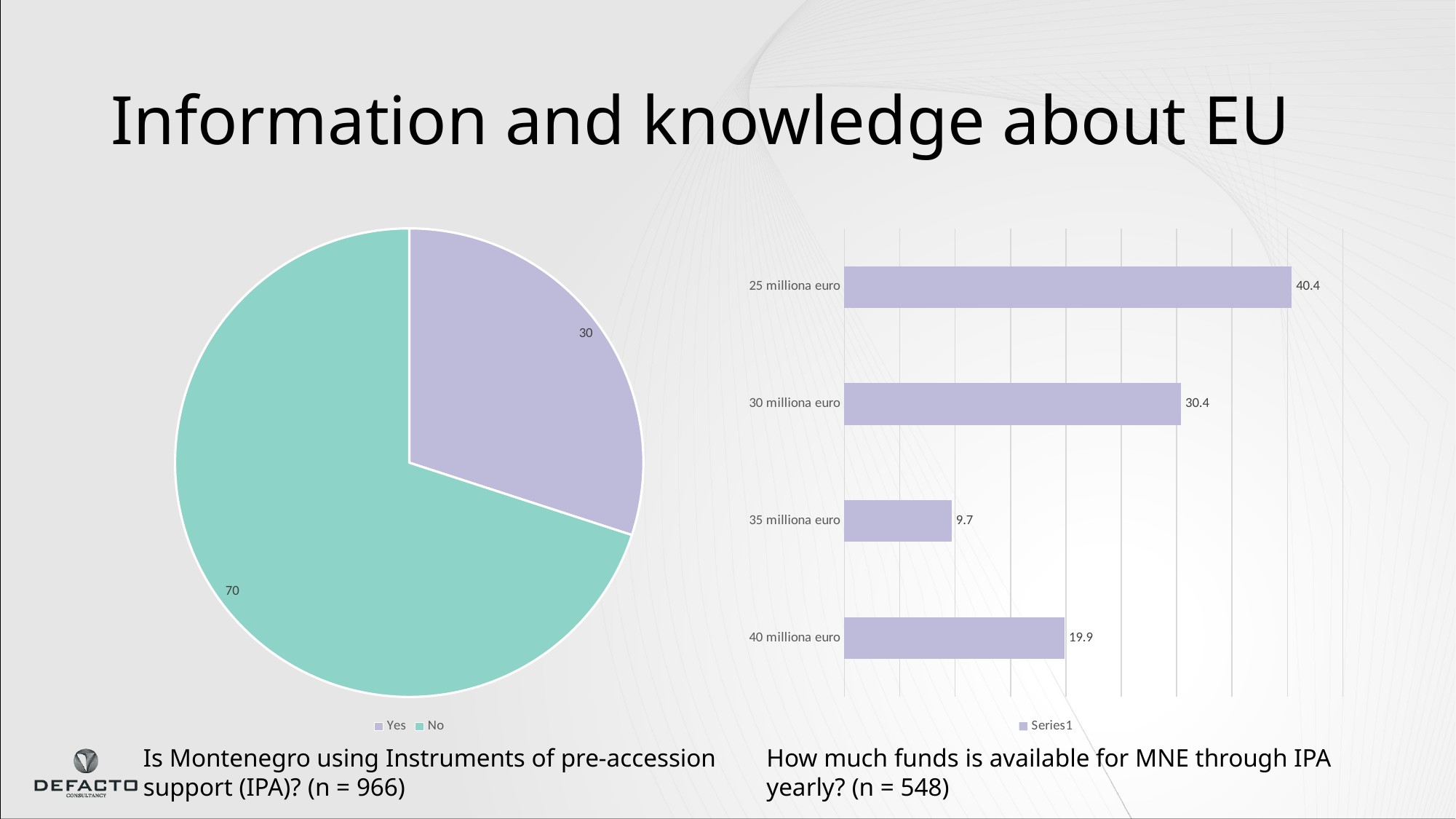
In the pie chart on the left, what is the value for Yes? 30 In the bar chart on the right, which category has the lowest value? 35 milliona euro In the pie chart on the left, what is the value for No? 70 In the bar chart on the right, how many categories are shown? 4 In the bar chart on the right, what is the value for 35 milliona euro? 9.7 In the pie chart on the left, which category has the larger slice? No In the bar chart on the right, what is the difference between the values for 30 milliona euro and 40 milliona euro? 10.5 In the pie chart on the left, what is the difference between the No and Yes values? 40 What kind of chart is the chart on the left? pie chart What kind of chart is the chart on the right? bar chart In the bar chart on the right, what is the value for 25 milliona euro? 40.4 In the bar chart on the right, which category has the highest value? 25 milliona euro